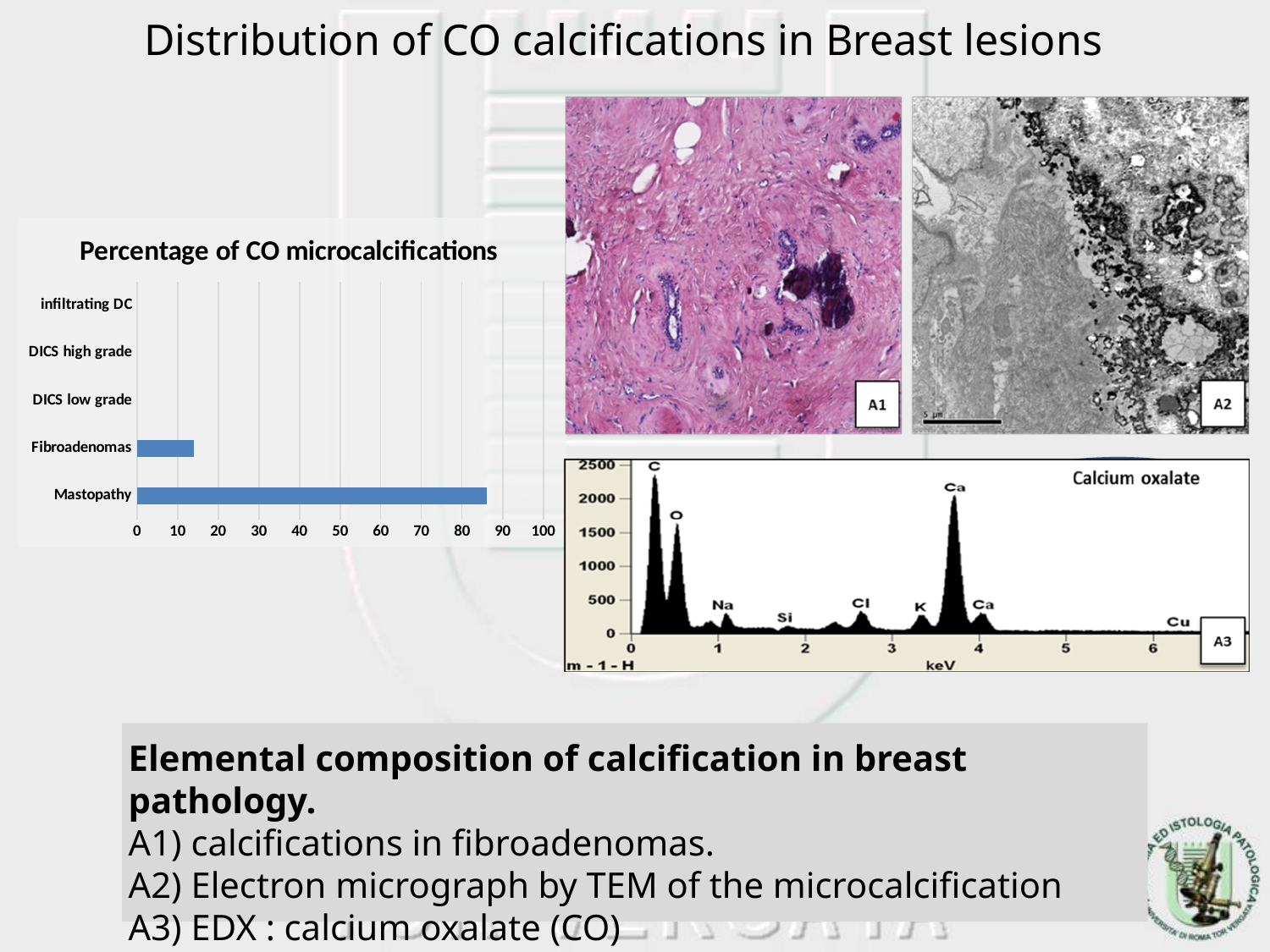
In the "Percentage of CO microcalcifications" chart, which is larger: Mastopathy or Fibroadenomas? Mastopathy How many categories are listed on the y axis of the "Percentage of CO microcalcifications" chart? 5 In the "Percentage of CO microcalcifications" chart, is the value for Mastopathy greater or less than 50? greater What is the maximum value shown on the x axis of the "Percentage of CO microcalcifications" chart? 100 In the "Percentage of CO microcalcifications" chart, how many categories have a visible bar? 2 In the "Percentage of CO microcalcifications" chart, is the value for Fibroadenomas greater or less than 20? less What is the title of the bar chart on the left of the slide? Percentage of CO microcalcifications In the "Percentage of CO microcalcifications" chart, is the value for Mastopathy greater or less than 80? greater In the "Percentage of CO microcalcifications" chart, which category has the highest value? Mastopathy What kind of chart is "Percentage of CO microcalcifications"? bar chart